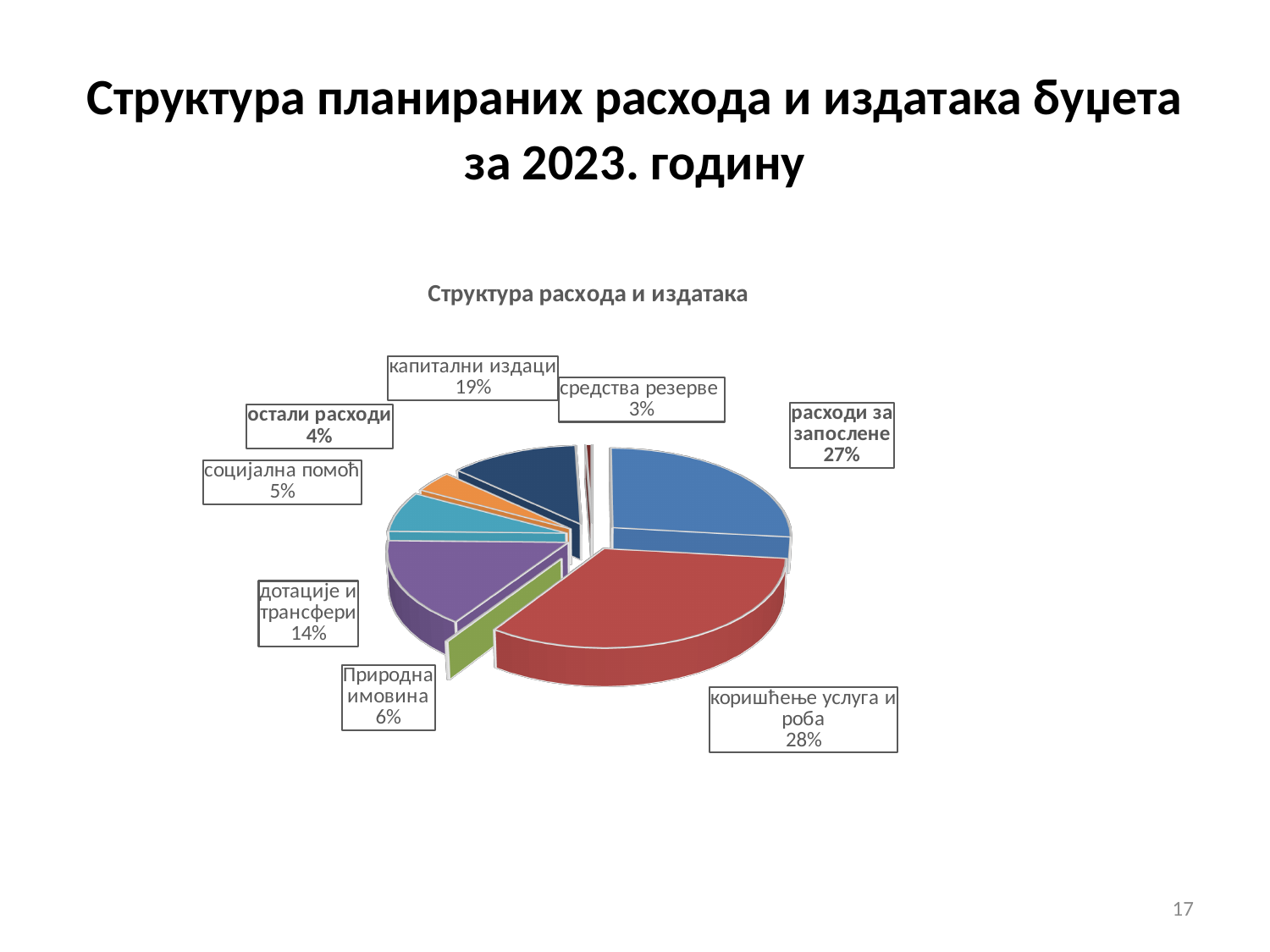
Which category has the smallest share of the pie? средства резерве What percentage is shown for дотације и трансфери? 14% What is the title of the chart? Структура расхода и издатака How many categories are shown in the pie chart? 8 What percentage is shown for капитални издаци? 19% Which is larger, the share for социјална помоћ or the share for Природна имовина? Природна имовина What percentage is shown for расходи за запослене? 27% What share of the pie is labelled for коришћење услуга и роба? 28% What type of chart is shown on the slide? pie chart What is the difference in percentage points between капитални издаци and дотације и трансфери? 5 Which category has the largest share of the pie? коришћење услуга и роба What percentage is shown for остали расходи? 4%